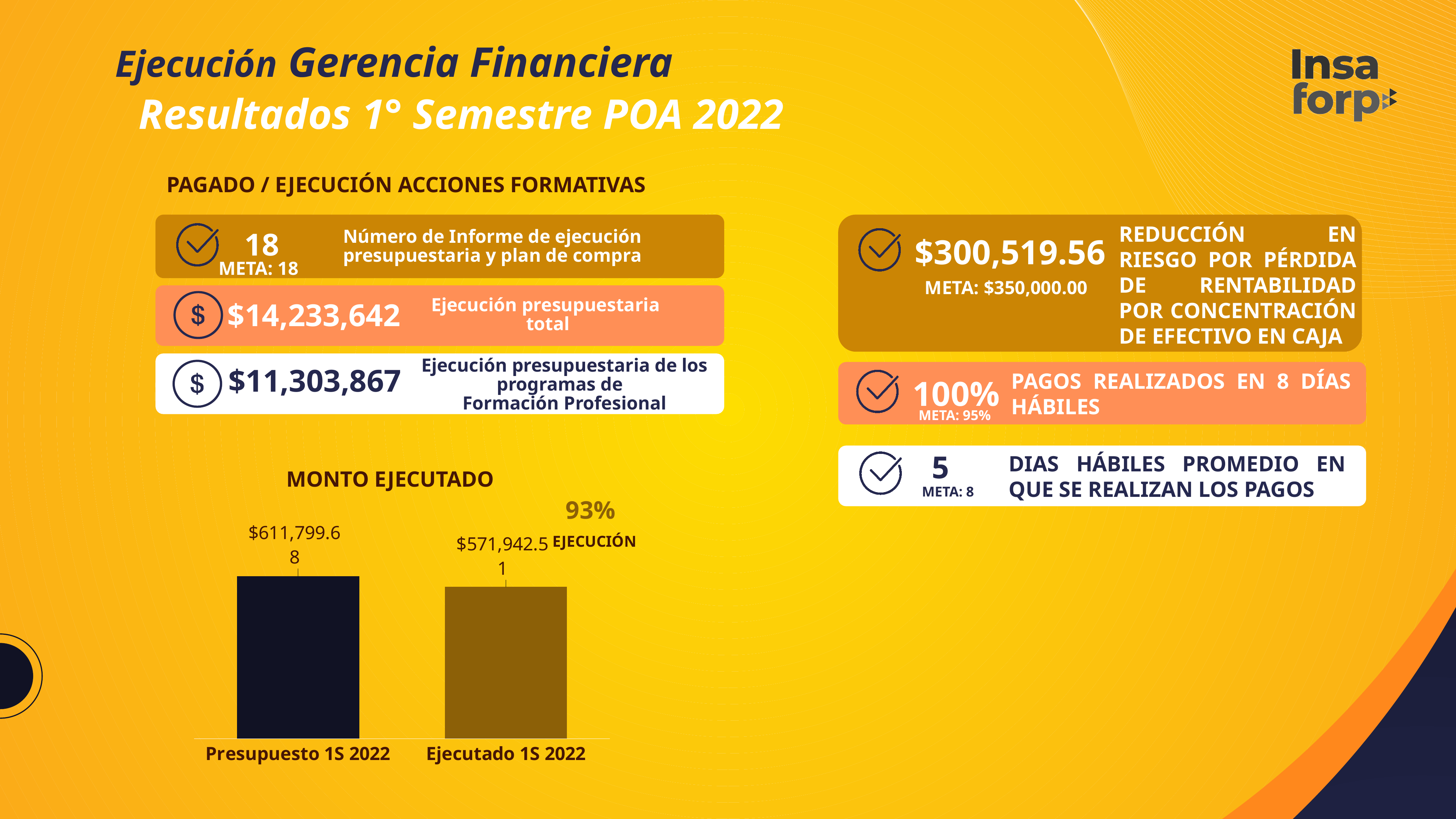
Which category has the highest value in the MONTO EJECUTADO chart? Presupuesto 1S 2022 What is the title of the bar chart on the slide? MONTO EJECUTADO How many bars are shown in the MONTO EJECUTADO chart? 2 What is the difference between Presupuesto 1S 2022 and Ejecutado 1S 2022 in the MONTO EJECUTADO chart? $39,857.17 What execution percentage is annotated next to the Ejecutado 1S 2022 bar in the MONTO EJECUTADO chart? 93% Which category has the lowest value in the MONTO EJECUTADO chart? Ejecutado 1S 2022 What is the value for Presupuesto 1S 2022 in the MONTO EJECUTADO chart? $611,799.68 Do the values in the MONTO EJECUTADO chart rise or fall from left to right? Fall In the MONTO EJECUTADO chart, which is larger: Presupuesto 1S 2022 or Ejecutado 1S 2022? Presupuesto 1S 2022 What kind of chart is the MONTO EJECUTADO chart? Bar chart What is the value for Ejecutado 1S 2022 in the MONTO EJECUTADO chart? $571,942.51